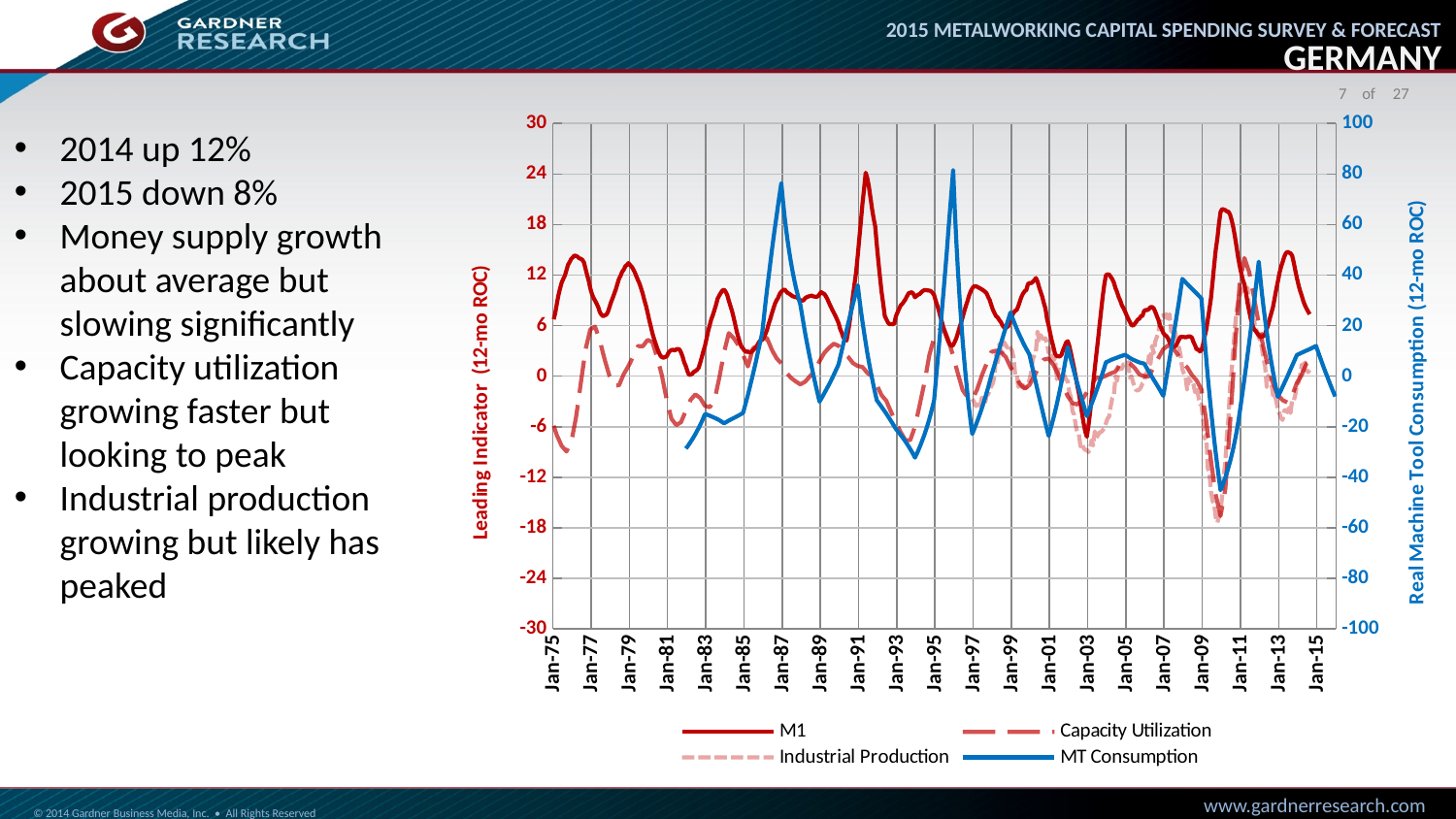
Is the peak value of M1 around Jan-91 greater or less than 18 on the left axis? greater What is the title of the left vertical axis of the chart? Leading Indicator (12-mo ROC) How many year labels are shown along the x axis of the chart? 21 What kind of chart is shown on the slide? line chart What are the minimum and maximum values shown on the right vertical axis? -100 and 100 How many series does the chart's legend list? 4 Does the M1 line rise or fall between Jan-13 and Jan-15? fall Is the value of M1 at Jan-75 greater or less than 0 on the left axis? greater Which series in the chart is drawn as a solid blue line? MT Consumption Is the peak value of MT Consumption around Jan-95 greater or less than 60 on the right axis? greater